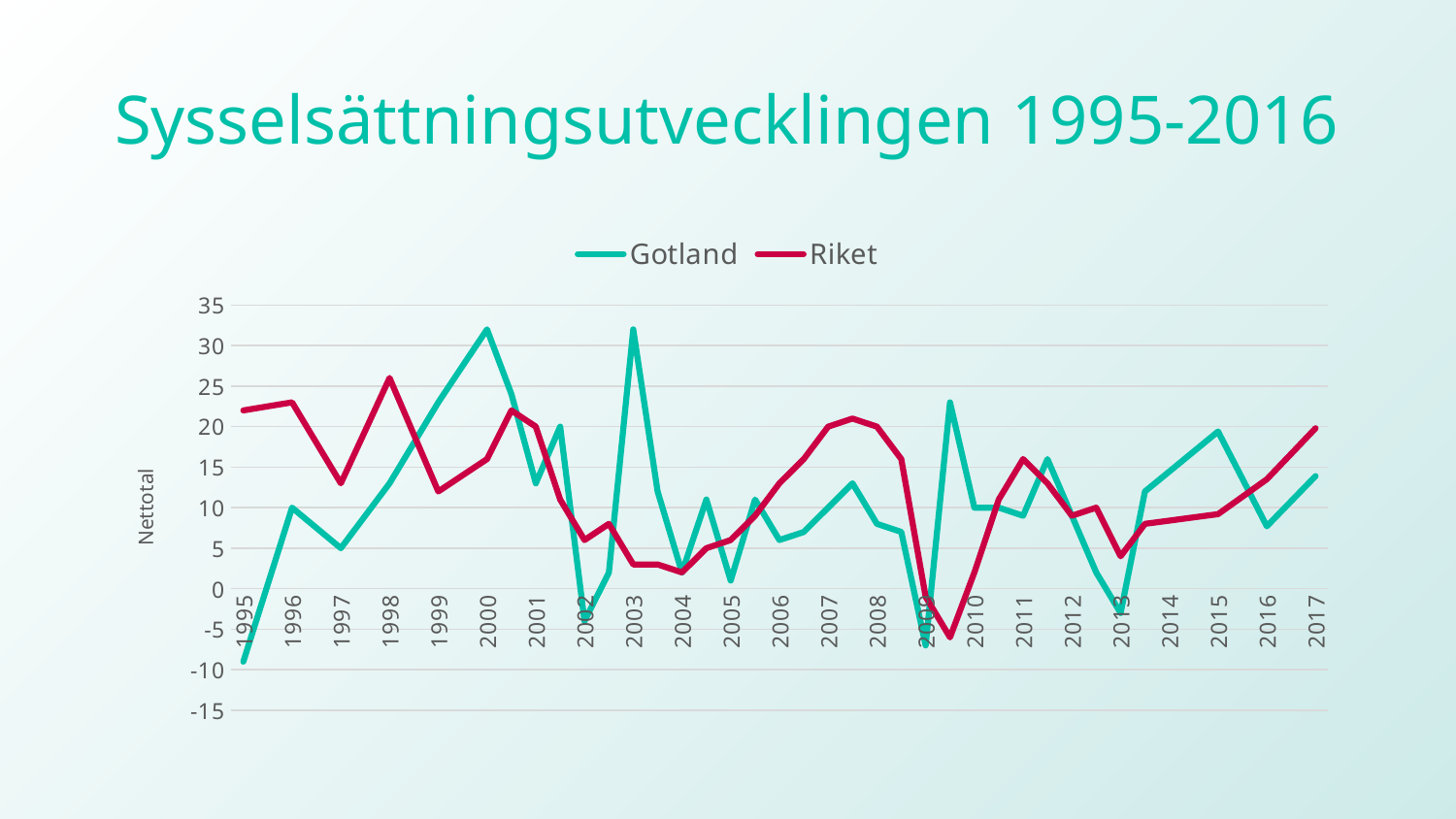
In which year does the Riket series reach its highest value? 1998 Is the value for Gotland in 2000 greater or less than 30? greater What kind of chart is shown on the slide? line chart Which series has the larger value in 1998, Gotland or Riket? Riket What is the label on the vertical axis? Nettotal Is the value for Gotland in 1995 greater or less than -5? less Is the value for Riket in 2004 greater or less than 5? less Which series has the lowest value in 1995? Gotland Does the Riket series rise or fall from 2013 to 2017? rise In which year does the Gotland series reach its lowest value? 1995 How many series does the legend list? 2 Which series has the larger value in 2003, Gotland or Riket? Gotland